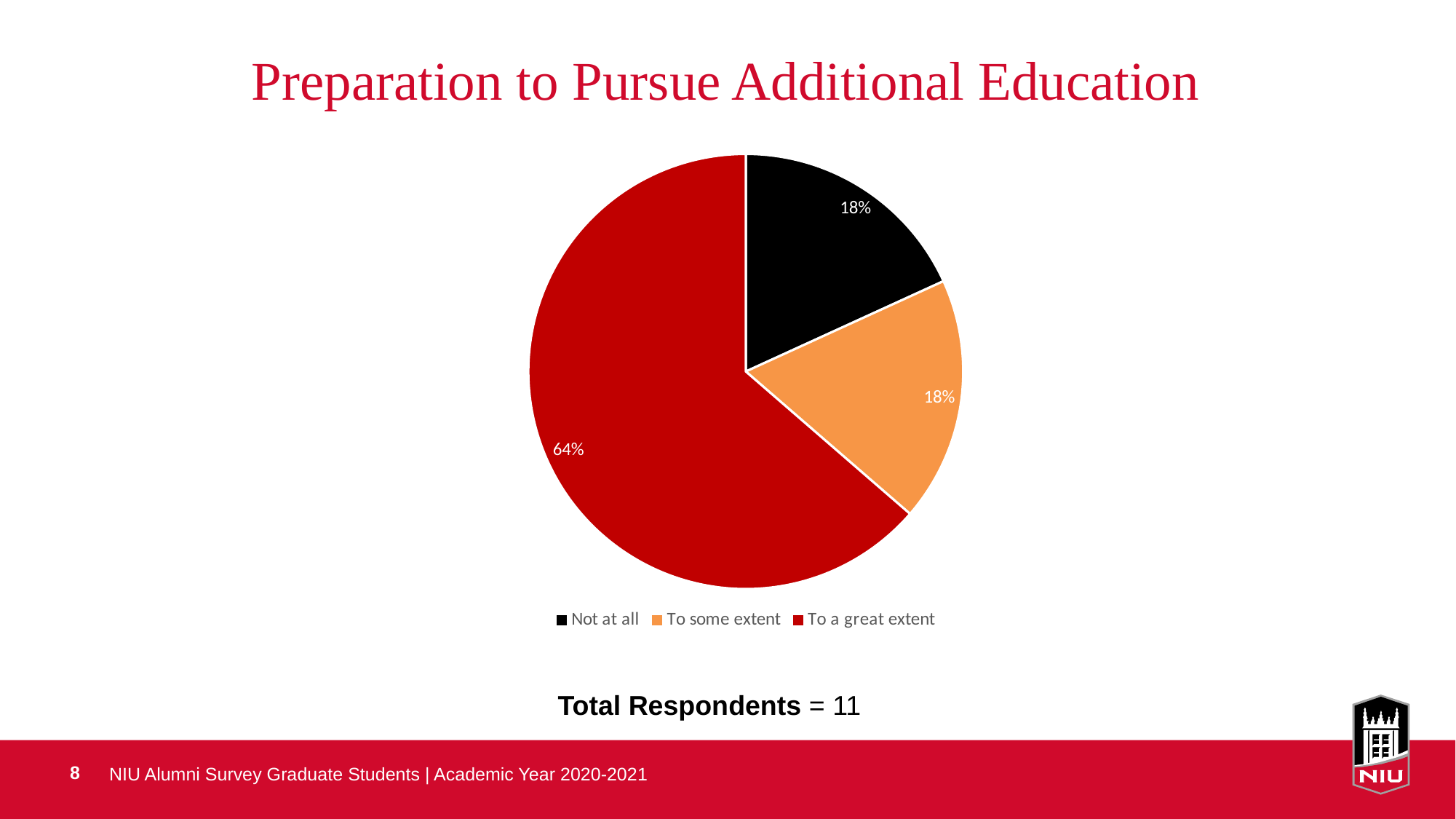
What is the combined share of "Not at all" and "To some extent"? 36% Which colour represents "To a great extent" in the pie chart? red What is the difference in percentage points between "To a great extent" and "Not at all"? 46 Which is larger, the share for "To a great extent" or the share for "To some extent"? To a great extent What kind of chart is shown on the slide? pie chart What share of respondents answered "To some extent"? 18% What share of respondents answered "To a great extent"? 64% How many entries does the legend list? 3 Which category has the largest slice of the pie? To a great extent How many slices does the pie chart have? 3 How many total respondents are reported below the chart? 11 What share of respondents answered "Not at all"? 18%